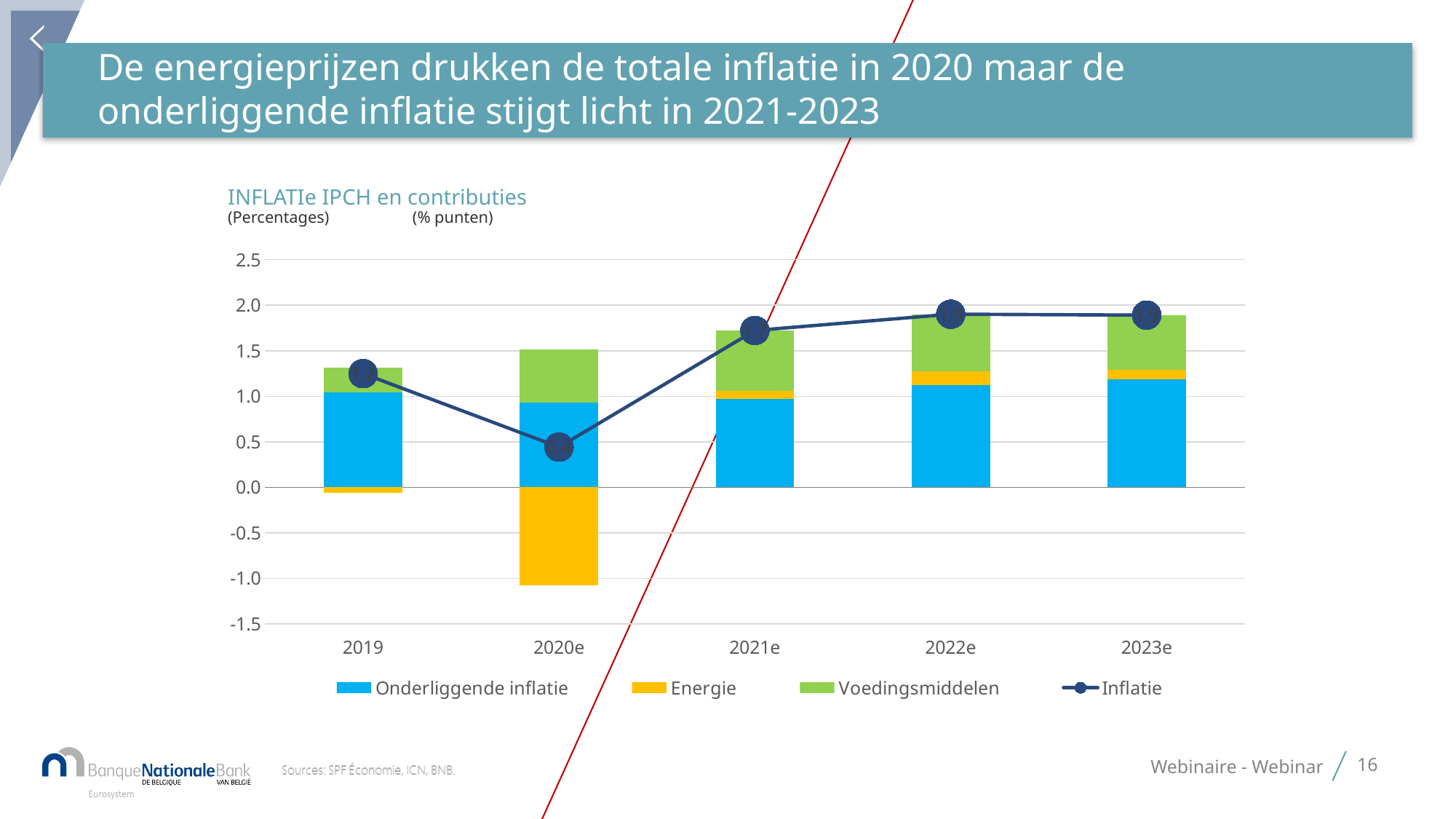
What is the value of the Inflatie line for 2022e? 1.9 What is the title of the chart? INFLATIe IPCH en contributies What kind of chart is used to show the contributions? bar chart Does the Inflatie line rise or fall from 2020e to 2022e? rise What is the difference between the Inflatie values for 2022e and 2020e? 1.5 How many series does the legend list? 4 Is the Energie contribution for 2020e greater or less than -0.5? less Is the Onderliggende inflatie contribution for 2023e greater or less than 1.0? greater In which year does the Inflatie line reach its lowest value? 2020e How many years are shown on the x axis of the chart? 5 Which is larger, the Inflatie value for 2020e or for 2021e? 2021e What is the value of the Inflatie line for 2020e? 0.4